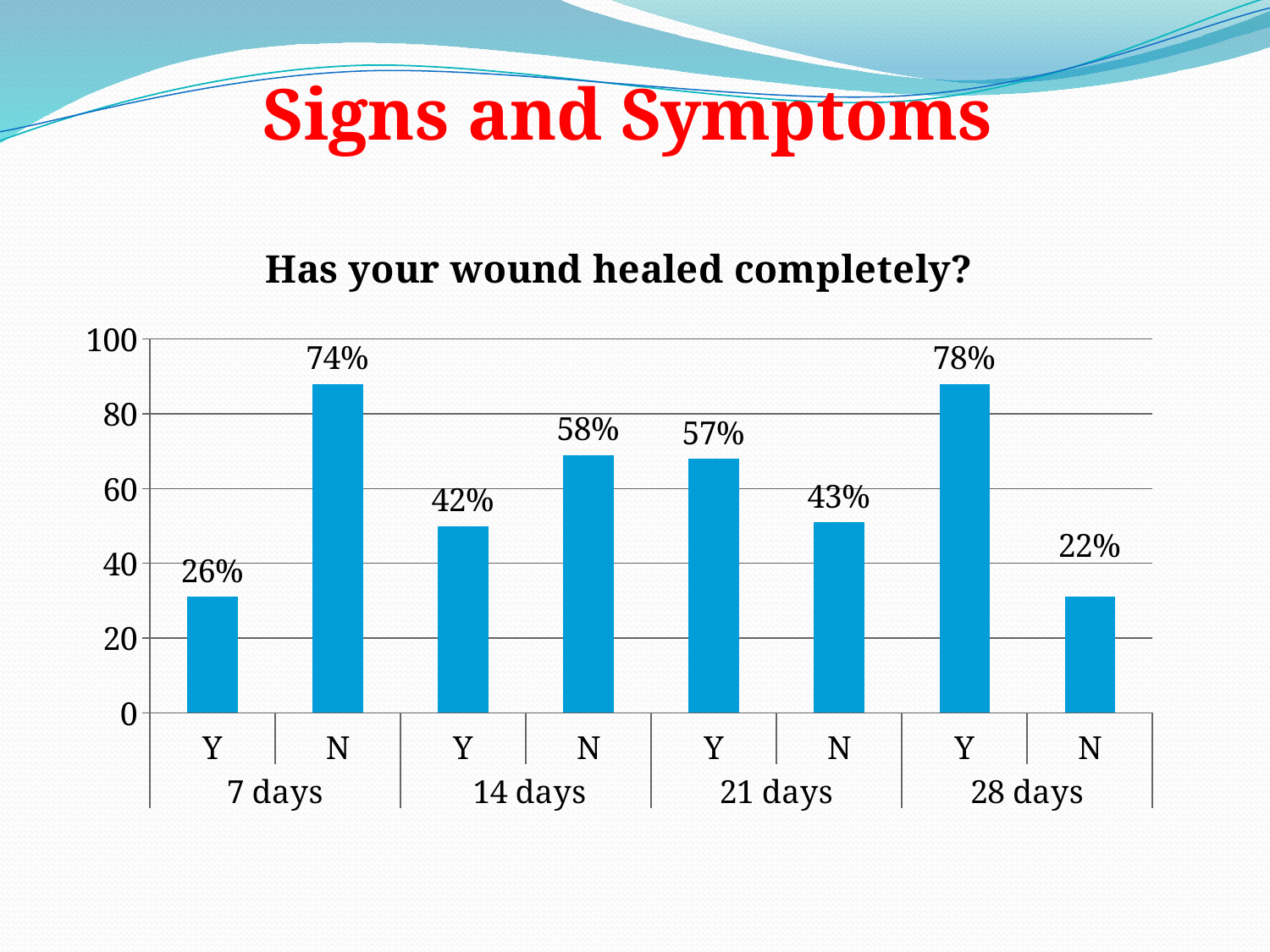
What is the value for Y at 28 days? 78% What is the value for Y at 7 days? 26% What is the value for N at 14 days? 58% Which bar has the highest value? Y at 28 days What is the value for N at 21 days? 43% Which is larger, the Y value at 14 days or the N value at 14 days? N at 14 days Which bar has the lowest value? N at 28 days What kind of chart is shown? Bar chart Do the Y values rise or fall from 7 days to 28 days? Rise What is the difference between the Y and N values at 7 days? 48% What is the title of the chart? Has your wound healed completely? How many bars are plotted in the chart? 8